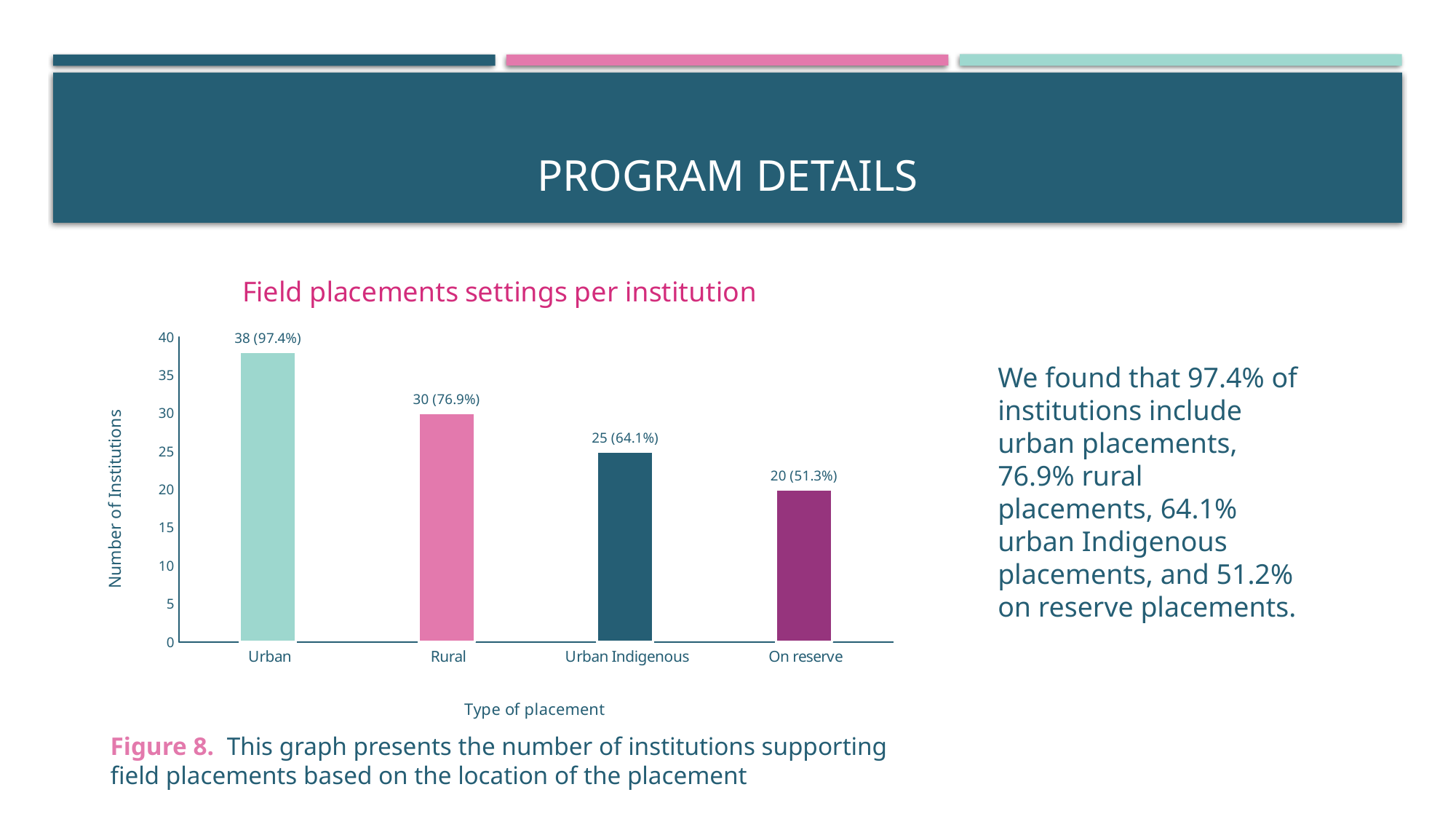
What is the title of the chart? Field placements settings per institution Do the values rise or fall from left to right along the x axis? Fall What is the value for On reserve? 20 (51.3%) Which has more institutions, Rural or Urban Indigenous? Rural How many types of placement are shown on the x axis? 4 Which type of placement has the highest number of institutions? Urban What is the difference in the number of institutions between Urban and On reserve? 18 Which type of placement has the lowest number of institutions? On reserve What is the value for Rural? 30 (76.9%) What is the value for Urban? 38 (97.4%) What kind of chart is this? Bar chart What is the value for Urban Indigenous? 25 (64.1%)